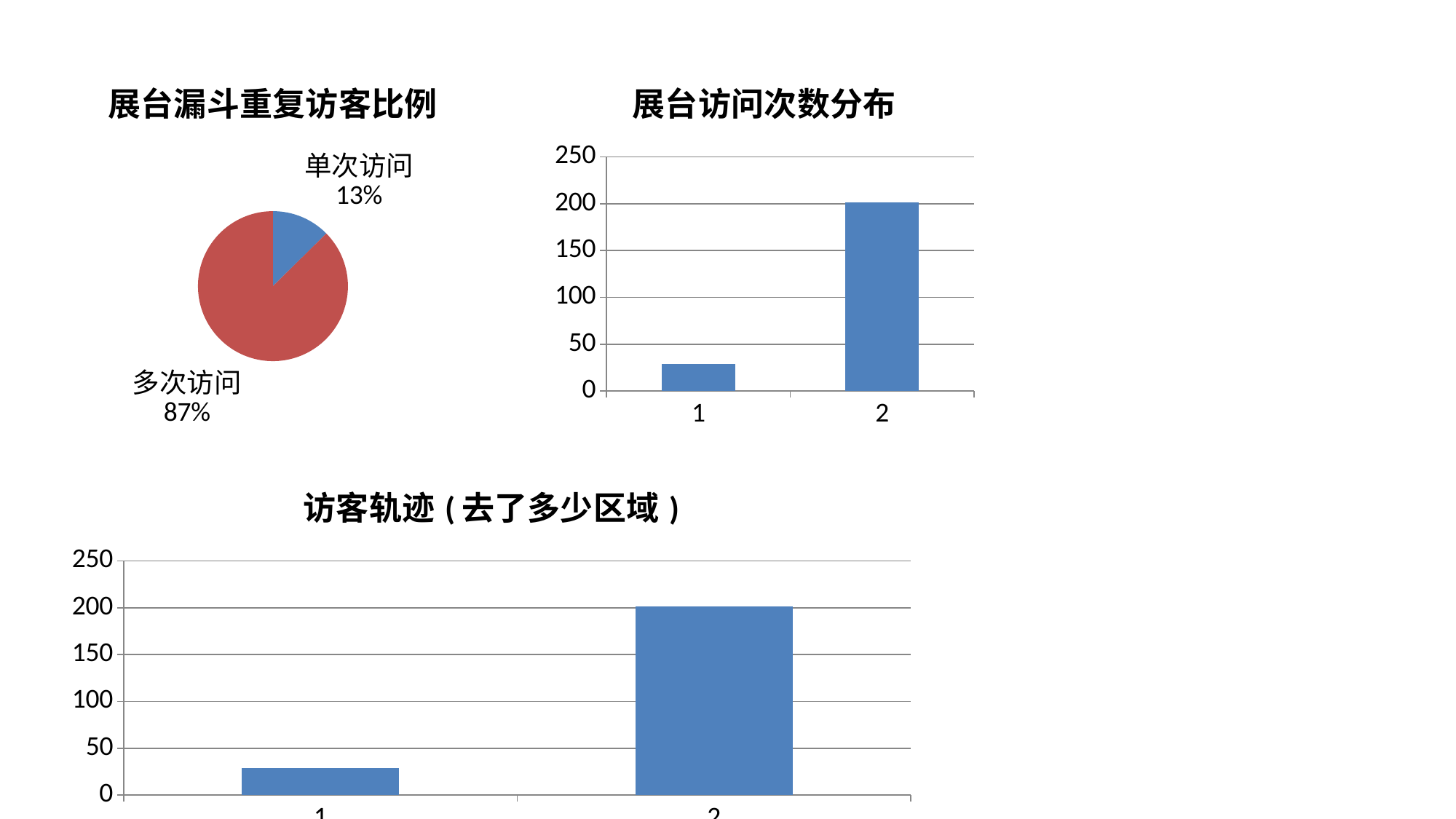
In the chart titled 展台访问次数分布, is the value for category 1 greater or less than 50? less In the chart titled 展台访问次数分布, is the value for category 2 greater or less than 150? greater In the chart titled 展台漏斗重复访客比例, what share of the pie is 单次访问? 13% In the chart titled 访客轨迹（去了多少区域）, is the value for category 1 greater or less than 50? less In the chart titled 展台漏斗重复访客比例, what is the difference in percentage points between 多次访问 and 单次访问? 74 In the chart titled 展台漏斗重复访客比例, which slice is the largest? 多次访问 What kind of chart is the one titled 展台漏斗重复访客比例? pie chart What kind of chart is the one titled 访客轨迹（去了多少区域）? bar chart How many categories are shown on the x axis of the chart titled 展台访问次数分布? 2 In the chart titled 访客轨迹（去了多少区域）, which category has the lower value? 1 In the chart titled 展台访问次数分布, which category has the higher value? 2 In the chart titled 展台漏斗重复访客比例, what share of the pie is 多次访问? 87%